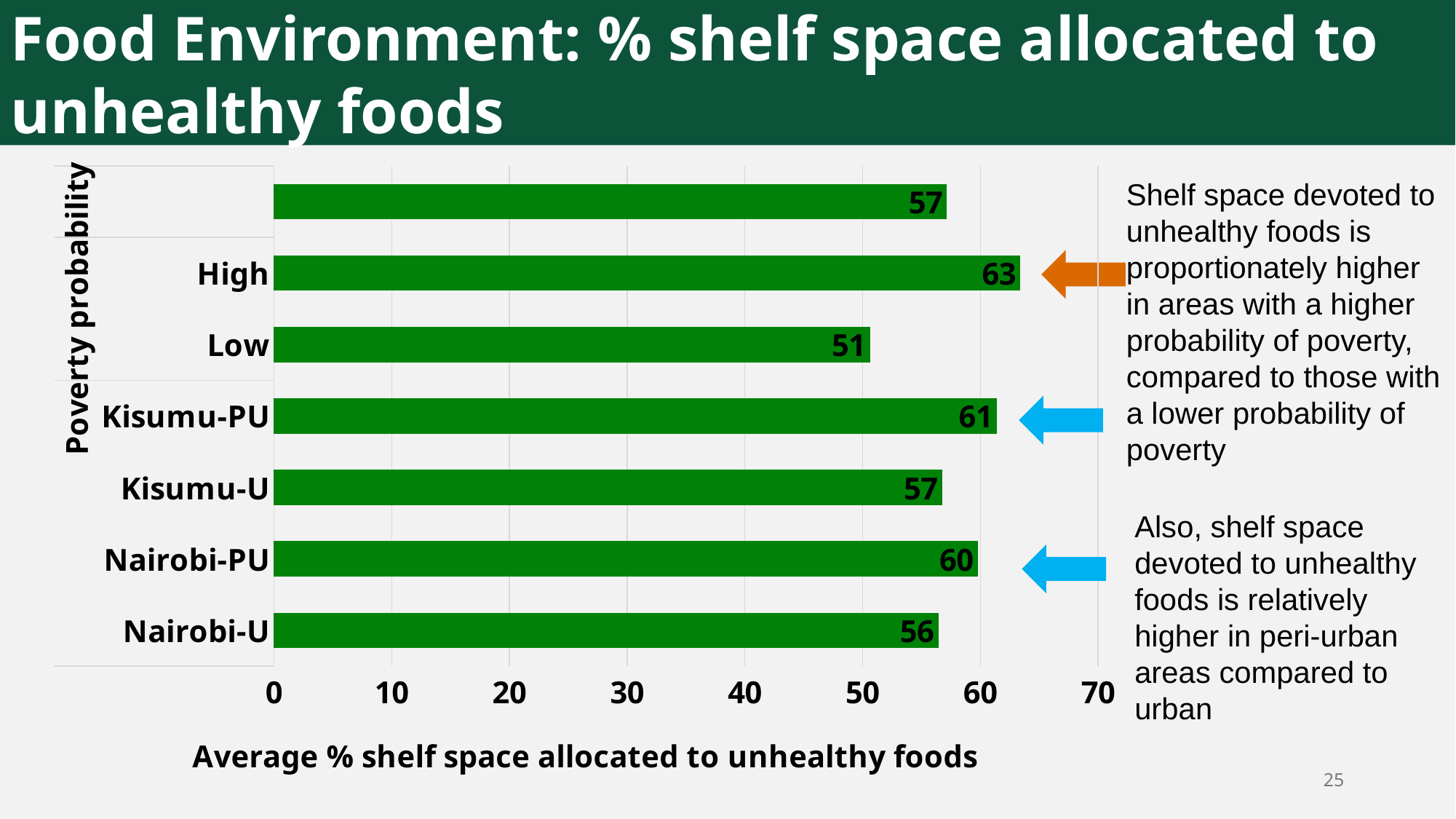
What is the value shown for Kisumu-PU? 61 Which labelled category has the highest average % shelf space allocated to unhealthy foods? High What is the average % shelf space allocated to unhealthy foods for the High poverty probability category? 63 Which has a larger value, Kisumu-PU or Kisumu-U? Kisumu-PU Which category has the lowest average % shelf space allocated to unhealthy foods? Low What is the value shown for Nairobi-U? 56 What is the difference between the values for High and Low poverty probability? 12 What is the value shown for Low poverty probability? 51 What is the title of the horizontal axis of the chart? Average % shelf space allocated to unhealthy foods What is the difference between the values for Nairobi-PU and Nairobi-U? 4 How many bars are plotted in the chart? 7 What kind of chart is shown on the slide? Bar chart